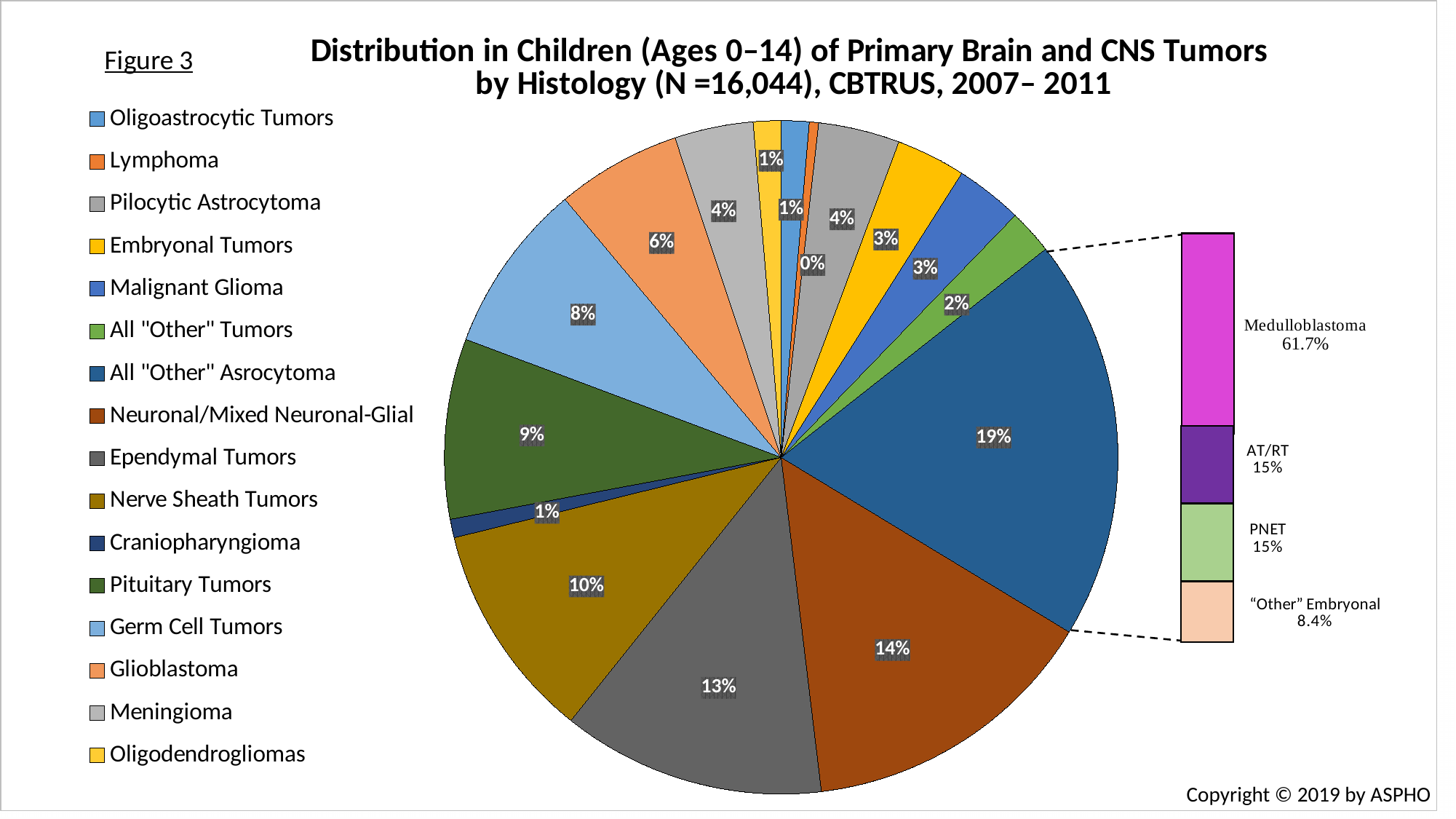
What kind of chart is shown on the slide? pie chart In the embryonal breakout bar, what percentage is "Other" Embryonal? 8.4% What percentage of the pie is Nerve Sheath Tumors? 10% Which histology has the smallest share of the pie? Lymphoma What percentage of the pie is Germ Cell Tumors? 8% What percentage of the pie is Ependymal Tumors? 13% What is the N value stated in the chart title? 16,044 Which histology has the largest share of the pie? All "Other" Asrocytoma In the embryonal breakout bar, what percentage is Medulloblastoma? 61.7% Which has a larger share, Pituitary Tumors or Germ Cell Tumors? Pituitary Tumors How many histology categories does the legend list? 16 What is the difference in percentage points between Neuronal/Mixed Neuronal-Glial and Ependymal Tumors? 1%